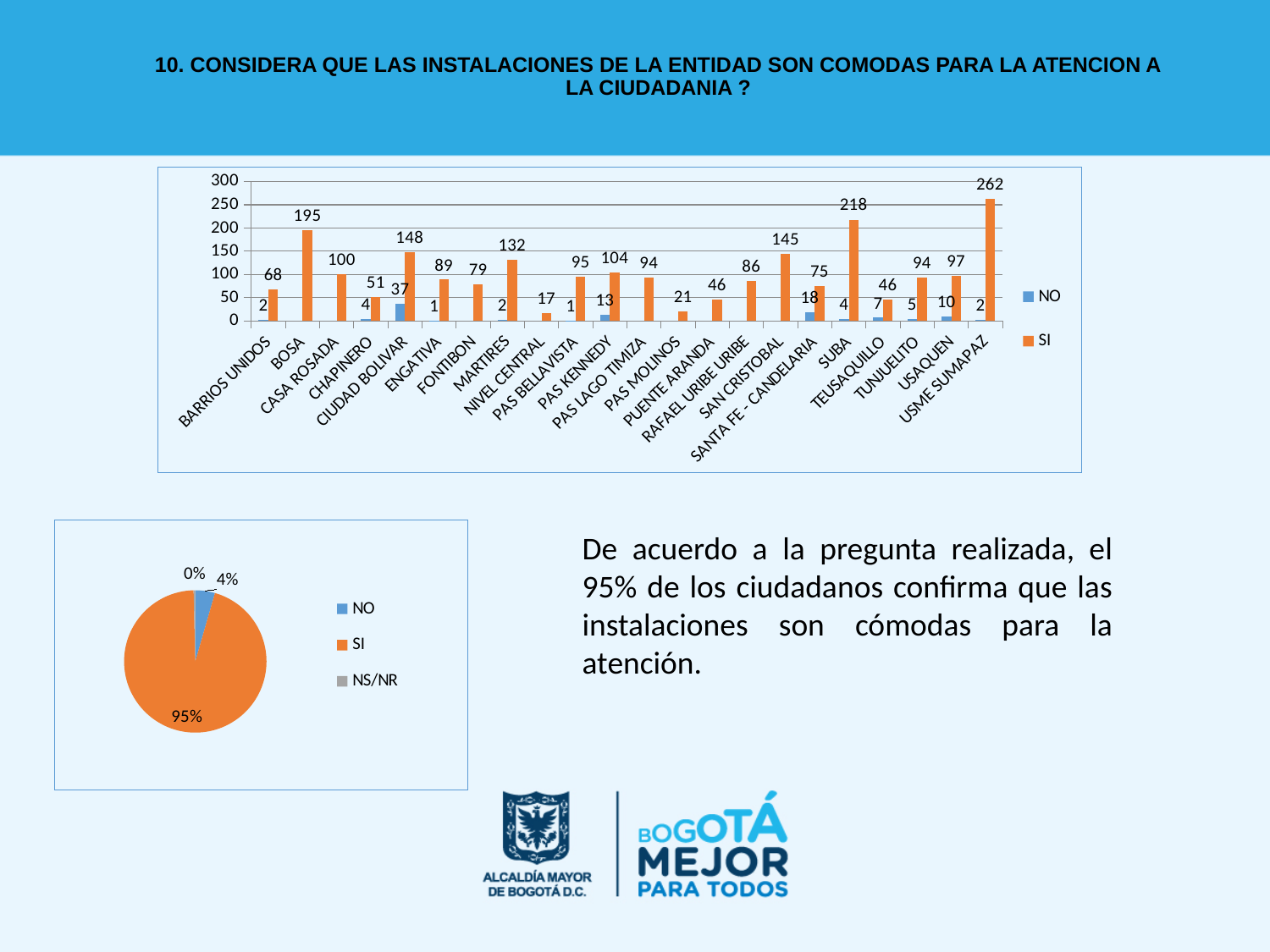
In the top bar chart, what is the difference between the SI values for USME SUMAPAZ and SUBA? 44 In the top bar chart, which category has the highest SI value? USME SUMAPAZ In the top bar chart, what is the NO value for CIUDAD BOLIVAR? 37 What kind of chart is the top chart on the slide? bar chart In the top bar chart, what is the SI value for BOSA? 195 How many entries does the legend of the pie chart list? 3 How many categories are shown on the x axis of the top bar chart? 22 In the top bar chart, which has a larger SI value, CIUDAD BOLIVAR or SAN CRISTOBAL? CIUDAD BOLIVAR In the pie chart, what share does SI have? 95% How many series does the legend of the top bar chart list? 2 In the pie chart, what share does NO have? 4% In the top bar chart, what is the SI value for SUBA? 218